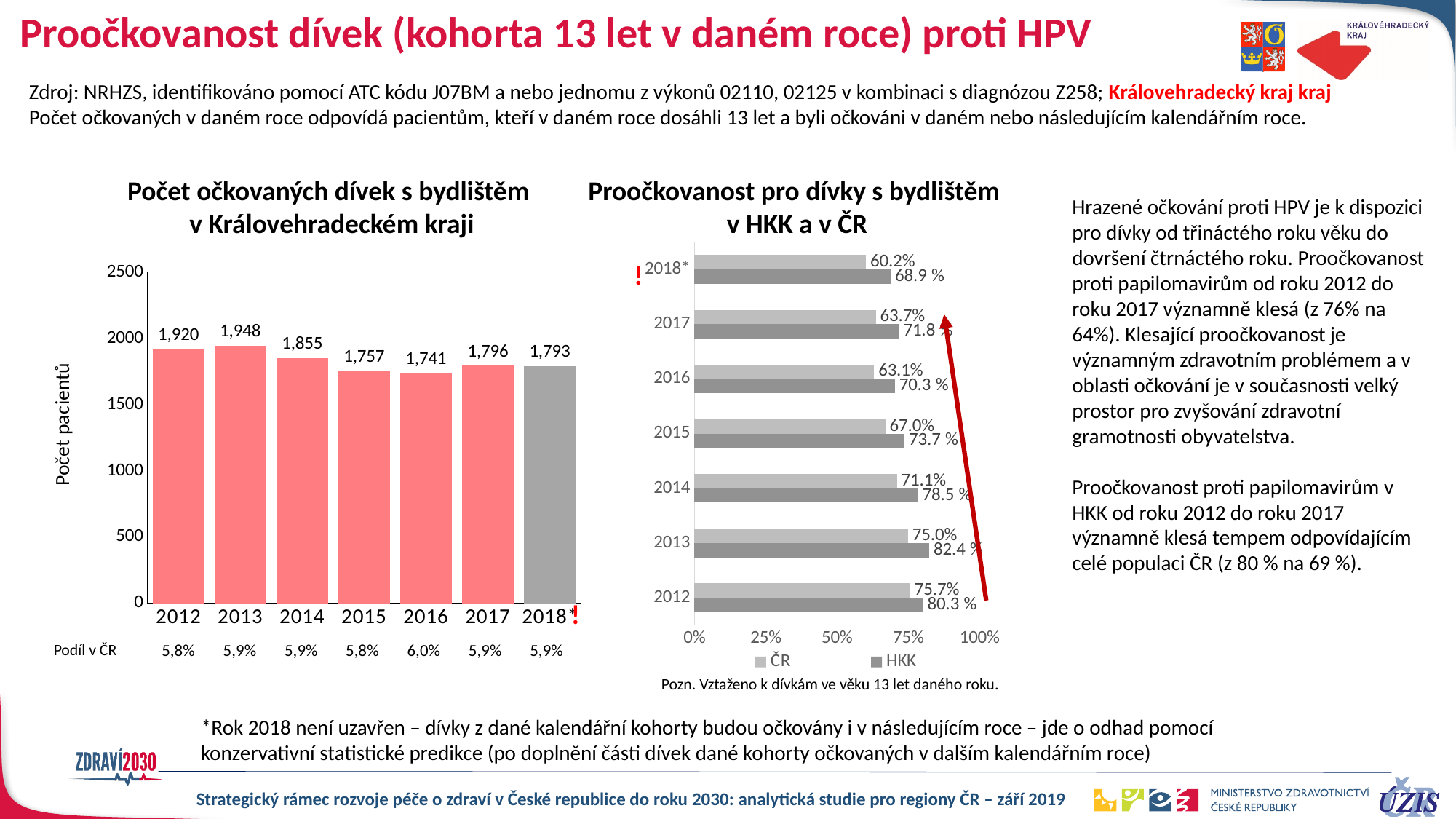
In the chart 'Proočkovanost pro dívky s bydlištěm v HKK a v ČR', which is larger for 2014, the ČR value or the HKK value? HKK In the chart 'Počet očkovaných dívek s bydlištěm v Královehradeckém kraji', which year has the highest value? 2013 How many years are shown in the chart 'Počet očkovaných dívek s bydlištěm v Královehradeckém kraji'? 7 In the chart 'Počet očkovaných dívek s bydlištěm v Královehradeckém kraji', what is the value for 2013? 1,948 In the chart 'Proočkovanost pro dívky s bydlištěm v HKK a v ČR', what is the HKK value for 2015? 73.7 % How many series does the legend of the chart 'Proočkovanost pro dívky s bydlištěm v HKK a v ČR' list? 2 What are the two legend entries in the chart 'Proočkovanost pro dívky s bydlištěm v HKK a v ČR'? ČR and HKK In the chart 'Počet očkovaných dívek s bydlištěm v Královehradeckém kraji', which year has the lowest value? 2016 In the chart 'Proočkovanost pro dívky s bydlištěm v HKK a v ČR', what is the ČR value for 2018*? 60.2% In the chart 'Proočkovanost pro dívky s bydlištěm v HKK a v ČR', do the ČR values rise or fall from 2012 to 2018*? fall What kind of chart is 'Počet očkovaných dívek s bydlištěm v Královehradeckém kraji'? bar chart In the chart 'Počet očkovaných dívek s bydlištěm v Královehradeckém kraji', what is the difference between the values for 2012 and 2016? 179